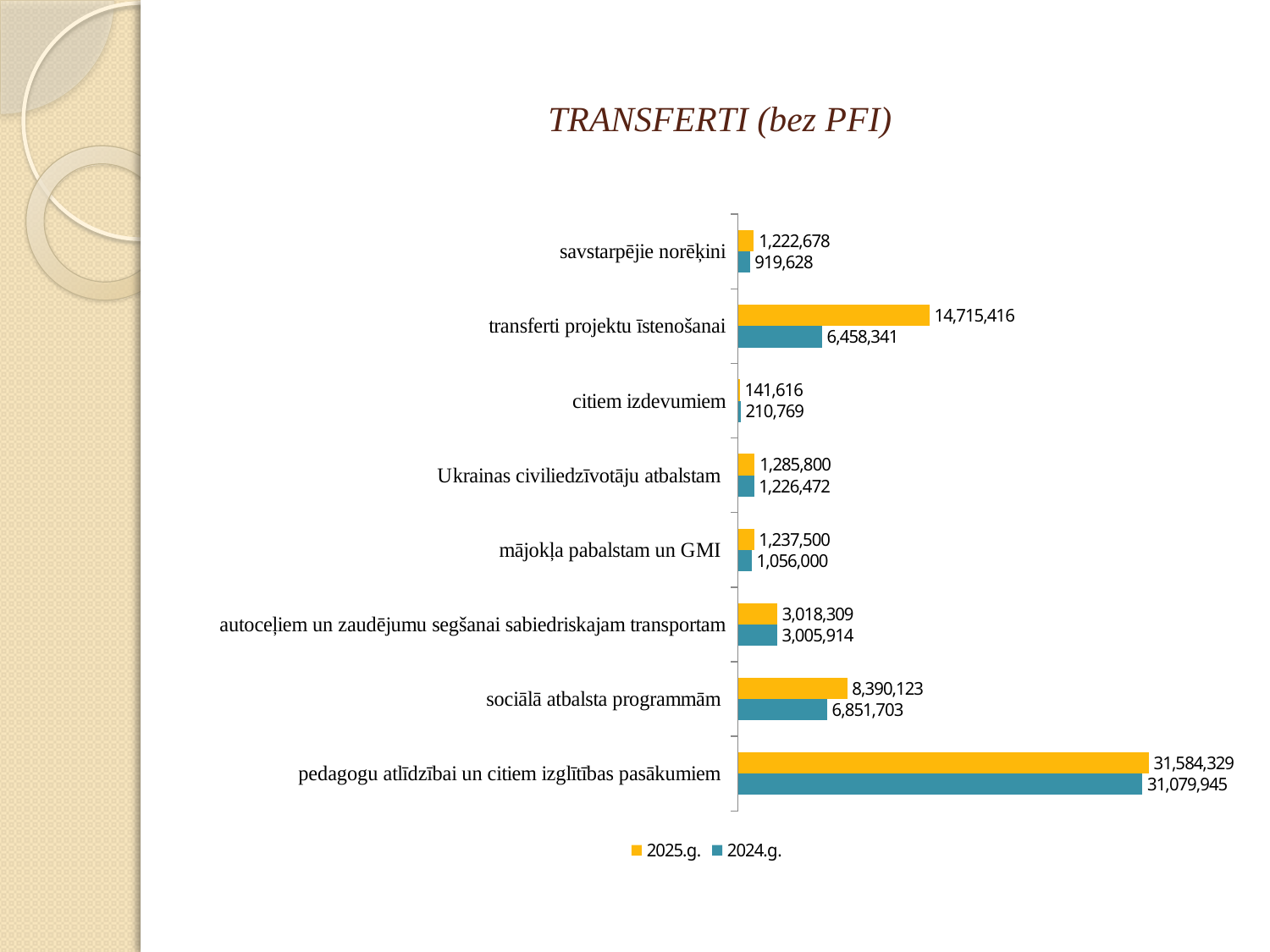
Which category has the lowest 2024.g. value? citiem izdevumiem What is the difference between the 2025.g. and 2024.g. values for transferti projektu īstenošanai? 8,257,075 Which category has the highest 2025.g. value? pedagogu atlīdzībai un citiem izglītības pasākumiem What is the 2025.g. value for transferti projektu īstenošanai? 14,715,416 What is the 2024.g. value for sociālā atbalsta programmām? 6,851,703 What is the difference between the 2025.g. and 2024.g. values for pedagogu atlīdzībai un citiem izglītības pasākumiem? 504,384 How many series does the legend list? 2 What is the title of the chart? TRANSFERTI (bez PFI) What is the 2024.g. value for savstarpējie norēķini? 919,628 How many categories are shown in the chart? 8 For citiem izdevumiem, which series has the larger value, 2025.g. or 2024.g.? 2024.g. What kind of chart is shown on the slide? bar chart